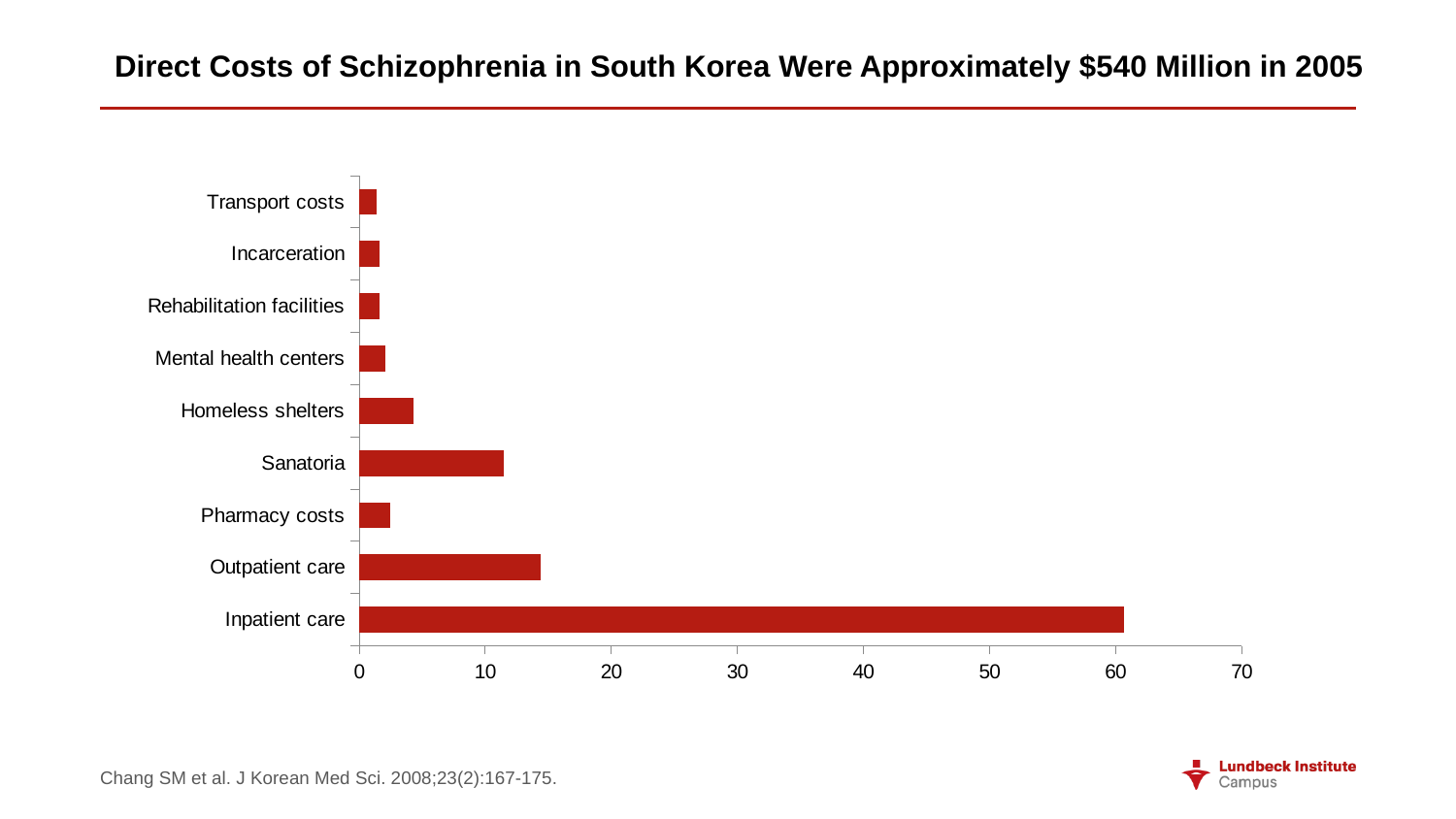
What is the maximum value shown on the horizontal axis of the chart? 70 What is the title of the chart on the slide? Direct Costs of Schizophrenia in South Korea Were Approximately $540 Million in 2005 What kind of chart is shown on the slide? Bar chart Is the value for Homeless shelters greater or less than 10? less Is the value for Outpatient care greater or less than 20? less Which is larger, the value for Outpatient care or the value for Sanatoria? Outpatient care Is the value for Inpatient care greater or less than 50? greater How many cost categories are plotted in the chart? 9 Which category has the highest direct cost in the chart? Inpatient care Which is larger, the value for Inpatient care or the value for Outpatient care? Inpatient care Which is larger, the value for Homeless shelters or the value for Pharmacy costs? Homeless shelters